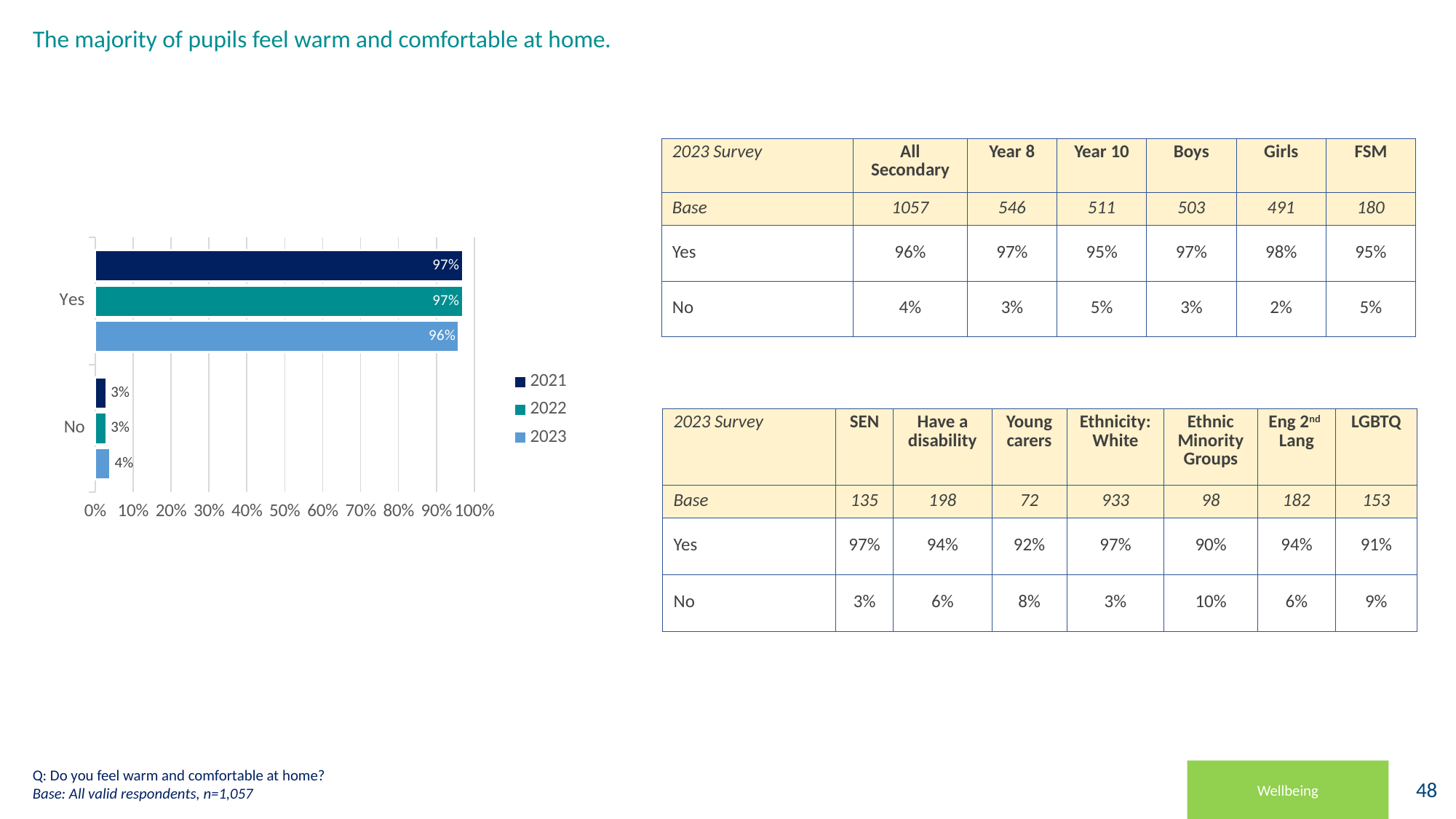
What percentage of pupils answered No in 2021? 3% Is the No value for 2023 larger or smaller than the No value for 2022? larger What is the difference between the Yes value in 2021 and the Yes value in 2023? 1% What percentage of pupils answered Yes in 2023? 96% Which year has the highest value for No? 2023 How many response categories are shown on the chart? 2 How many series does the chart legend list? 3 Which years are listed in the chart legend? 2021, 2022, 2023 What percentage of pupils answered No in 2023? 4% What type of chart is shown on the slide? bar chart Is the Yes value for 2023 greater or less than 90%? greater What percentage of pupils answered Yes in 2022? 97%